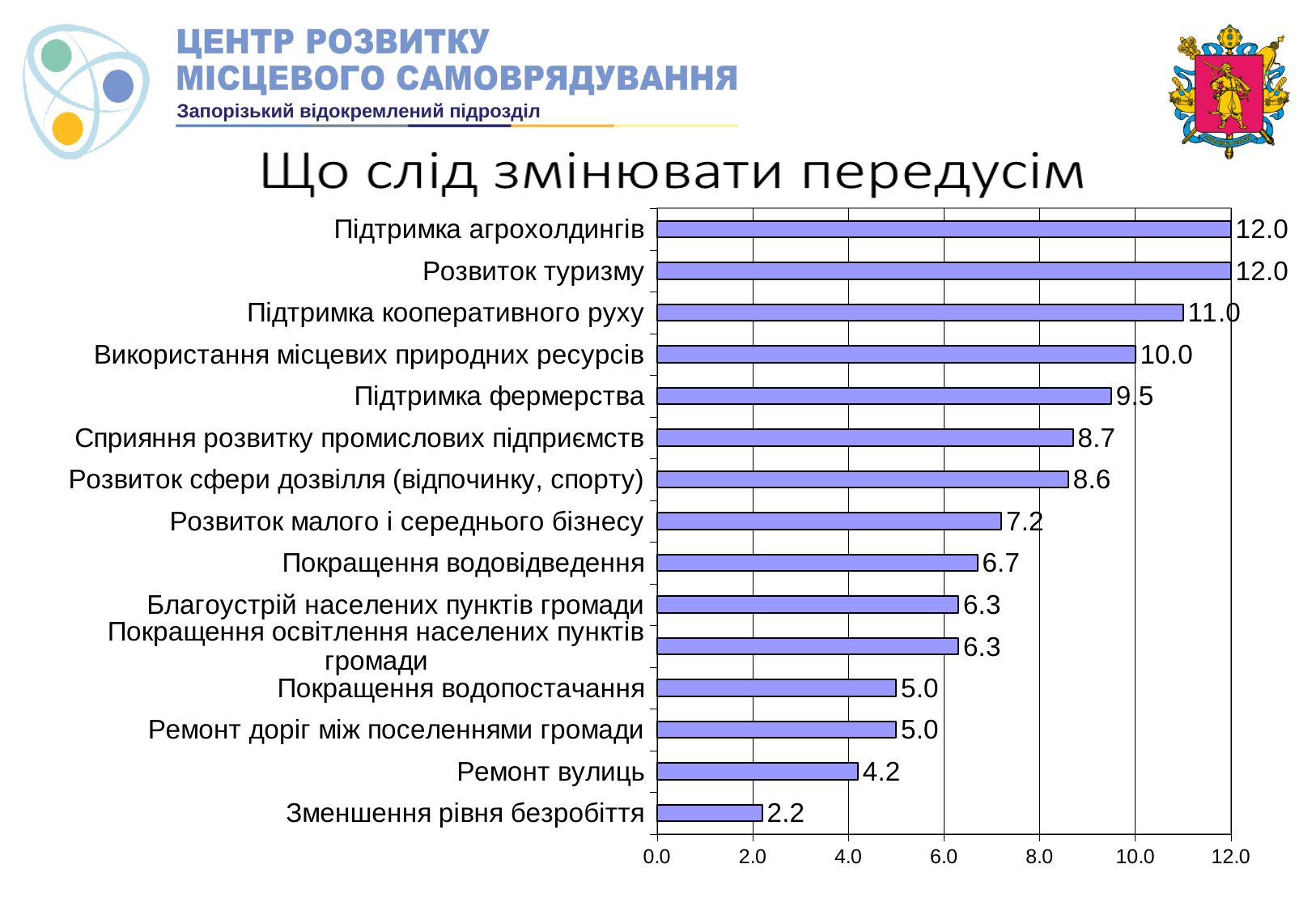
What is the value for Підтримка кооперативного руху? 11.0 Which category has the lowest value? Зменшення рівня безробіття How many categories are shown in the chart? 15 What is the difference between the values for Використання місцевих природних ресурсів and Покращення водовідведення? 3.3 What is the value for Розвиток малого і середнього бізнесу? 7.2 What is the value for Підтримка фермерства? 9.5 What kind of chart is shown on the slide? bar chart Which is larger, the value for Сприяння розвитку промислових підприємств or the value for Покращення водопостачання? Сприяння розвитку промислових підприємств What is the title of the chart? Що слід змінювати передусім What is the value for Ремонт вулиць? 4.2 Is the value for Розвиток сфери дозвілля (відпочинку, спорту) greater or less than 8.0? greater What is the difference between the values for Підтримка агрохолдингів and Зменшення рівня безробіття? 9.8